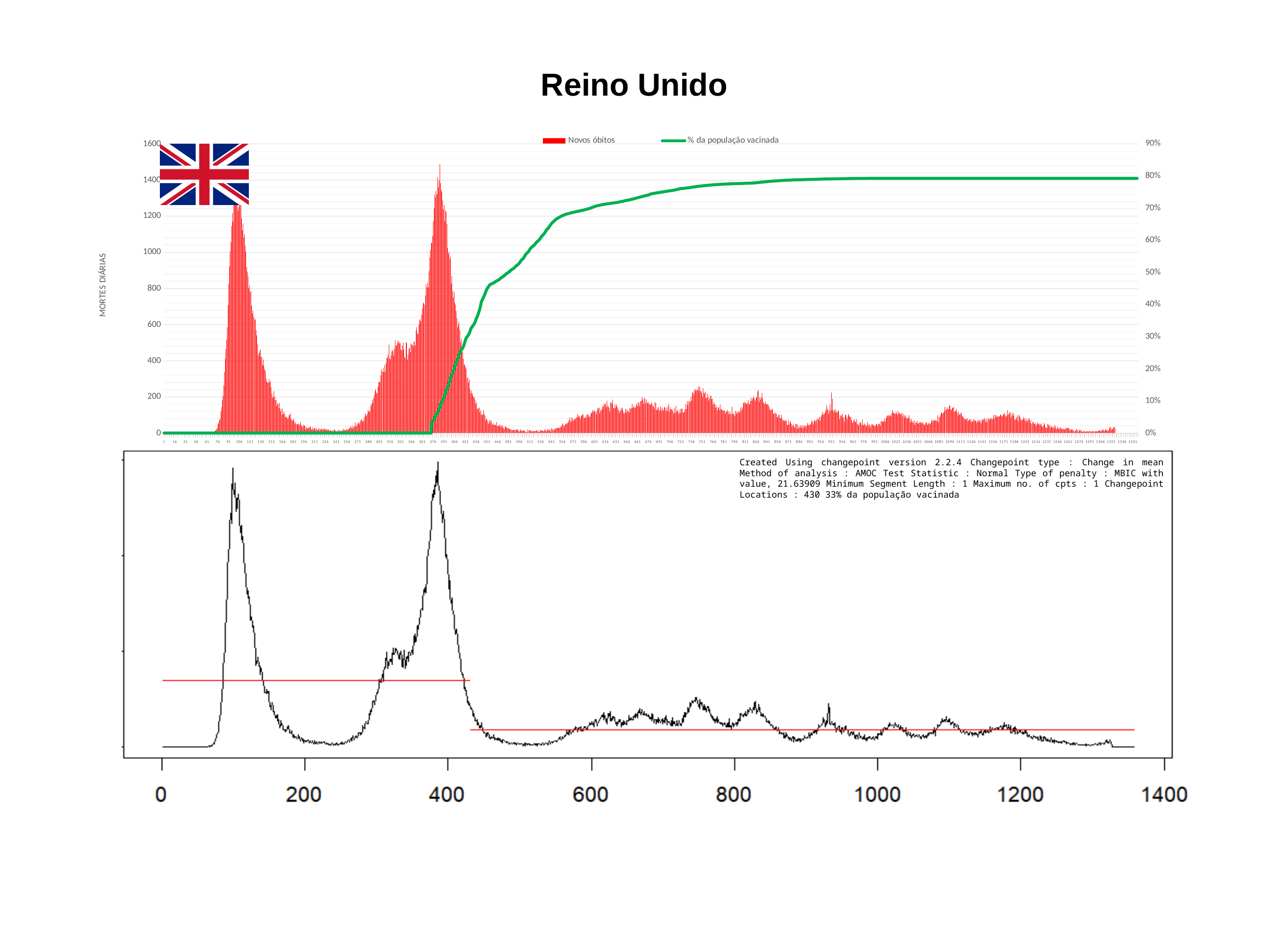
According to the text on the bottom chart, what percentage of the population was vaccinated at the changepoint? 33% On the top chart, are the red bars around x = 751 greater or less than 400? less On the top chart, does the green '% da população vacinada' line rise or fall along the x axis? rises What kind of chart is the bottom chart? line chart According to the text on the bottom chart, what is the changepoint location? 430 On the top chart, how many series does the legend list? 2 On the top chart, is the value of the green line at the left end of the chart greater or less than 10%? less On the top chart, what are the two legend entries? Novos óbitos; % da população vacinada On the top chart, is the value of the green line at the right end of the chart greater or less than 70%? greater On the bottom chart, what is the largest tick label on the x axis? 1400 On the top chart, what is the title of the left vertical axis? MORTES DIÁRIAS